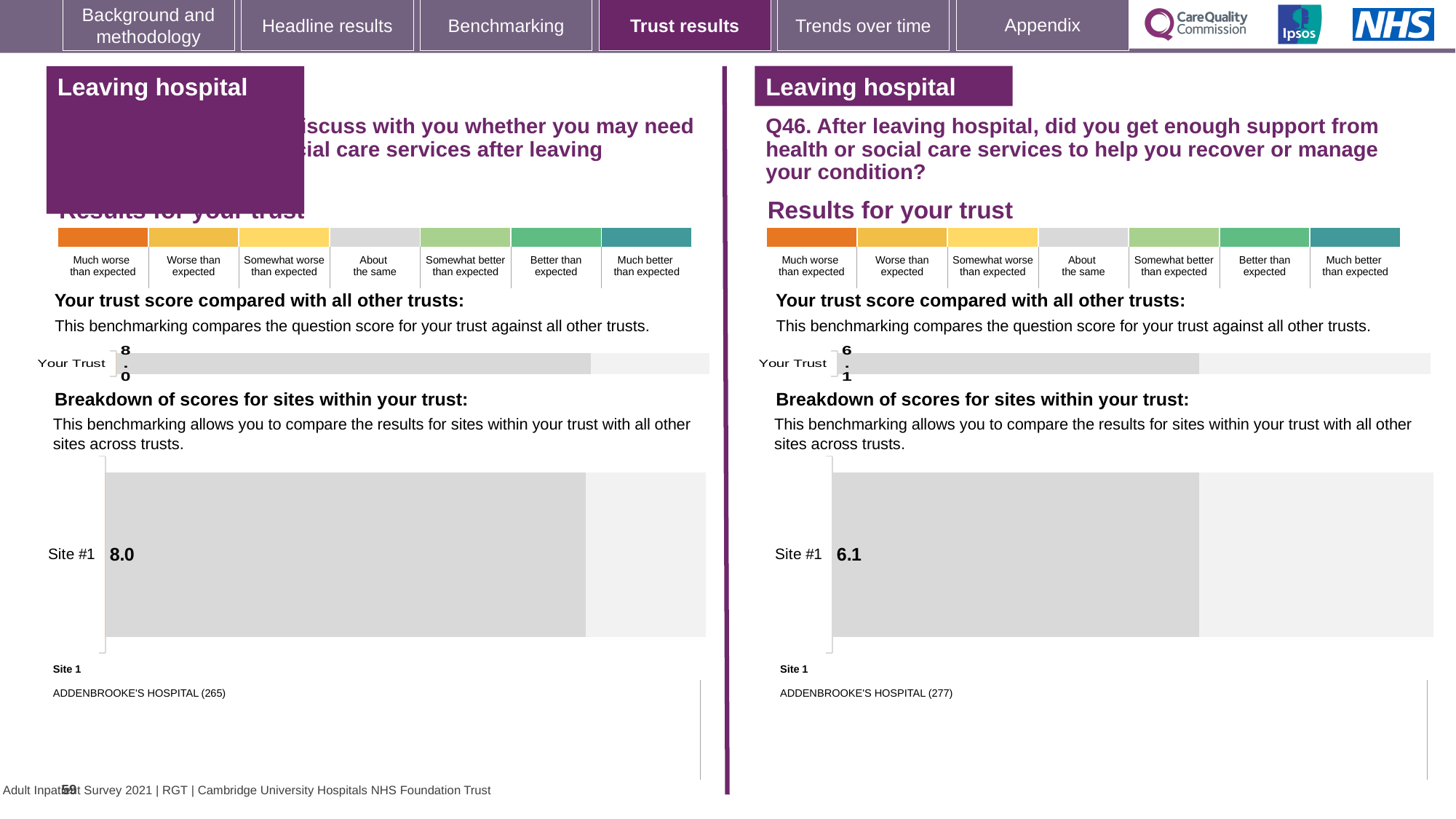
Is the Site #1 score in the right breakdown chart (Q46) greater or less than the Your Trust score on the left half of the slide? less What type of chart is used to show the Site #1 score on the right half of the slide? Bar chart What is the difference between the Your Trust score on the left half of the slide and the Your Trust score on the right half? 1.9 On the right half of the slide (Q46), what is the score shown for Your Trust in the 'Your trust score compared with all other trusts' chart? 6.1 How many sites are plotted in the right 'Breakdown of scores for sites within your trust' chart? 1 In the left 'Breakdown of scores for sites within your trust' chart, what is the score for Site #1? 8.0 On the left half of the slide, what is the score shown for Your Trust in the 'Your trust score compared with all other trusts' chart? 8.0 Which hospital is listed as Site 1 beneath the left breakdown chart? ADDENBROOKE'S HOSPITAL (265) Which hospital is listed as Site 1 beneath the right breakdown chart? ADDENBROOKE'S HOSPITAL (277) How many sites are plotted in the left 'Breakdown of scores for sites within your trust' chart? 1 Which is larger: the Site #1 score in the left breakdown chart or the Site #1 score in the right breakdown chart? The left chart (8.0) In the right 'Breakdown of scores for sites within your trust' chart (Q46), what is the score for Site #1? 6.1